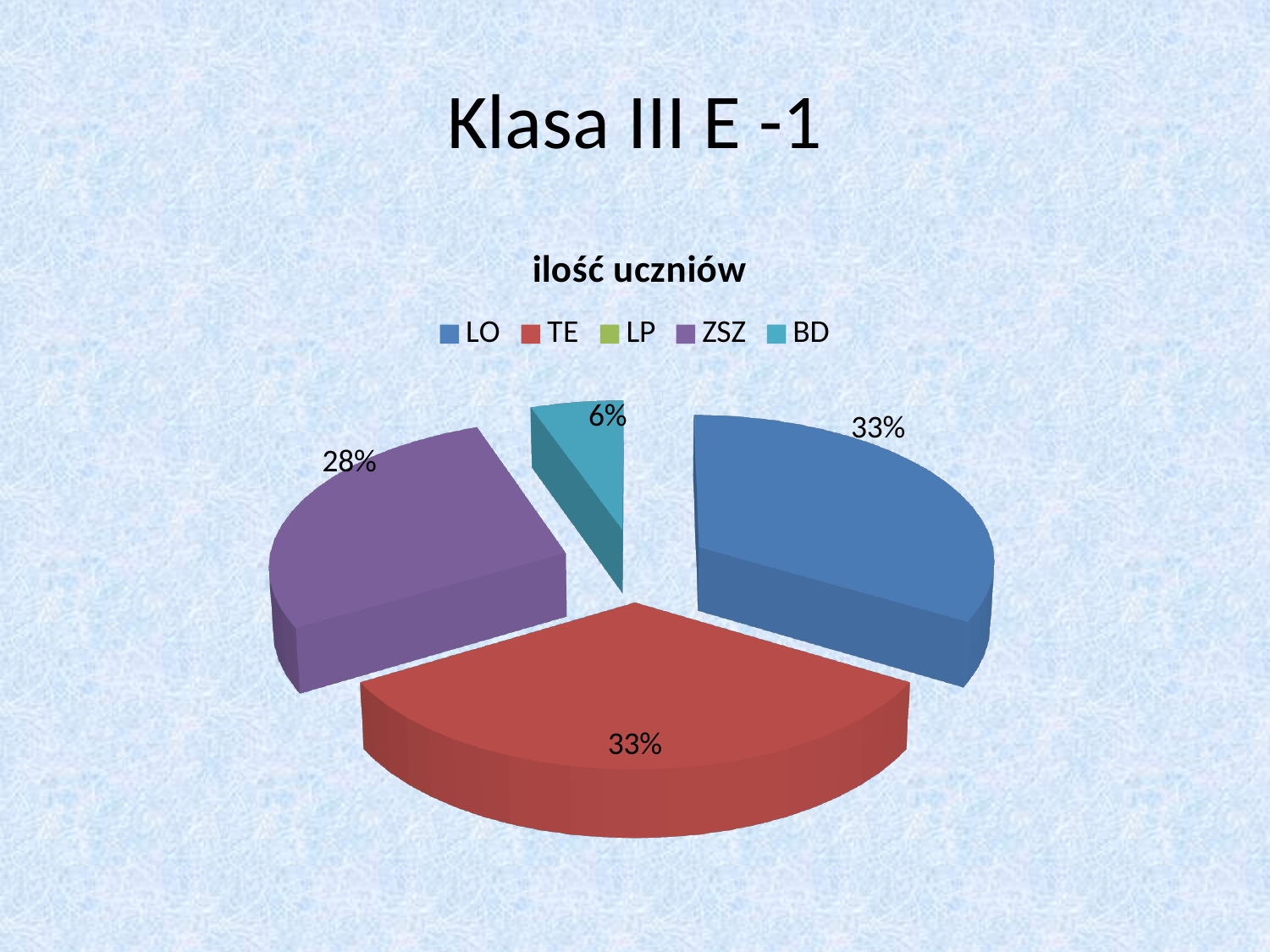
How many slices with percentage labels are visible in the pie? 4 What percentage of the pie does TE represent? 33% Which category has the smallest slice of the pie? BD What kind of chart is shown on the slide? Pie chart Which is larger, the slice for ZSZ or the slice for BD? ZSZ How many entries does the legend list? 5 What percentage of the pie does BD represent? 6% What is the title of the chart? ilość uczniów What percentage of the pie does ZSZ represent? 28% What is the difference in percentage points between the ZSZ slice and the BD slice? 22 What is the difference in percentage points between the LO slice and the ZSZ slice? 5 What percentage of the pie does LO represent? 33%